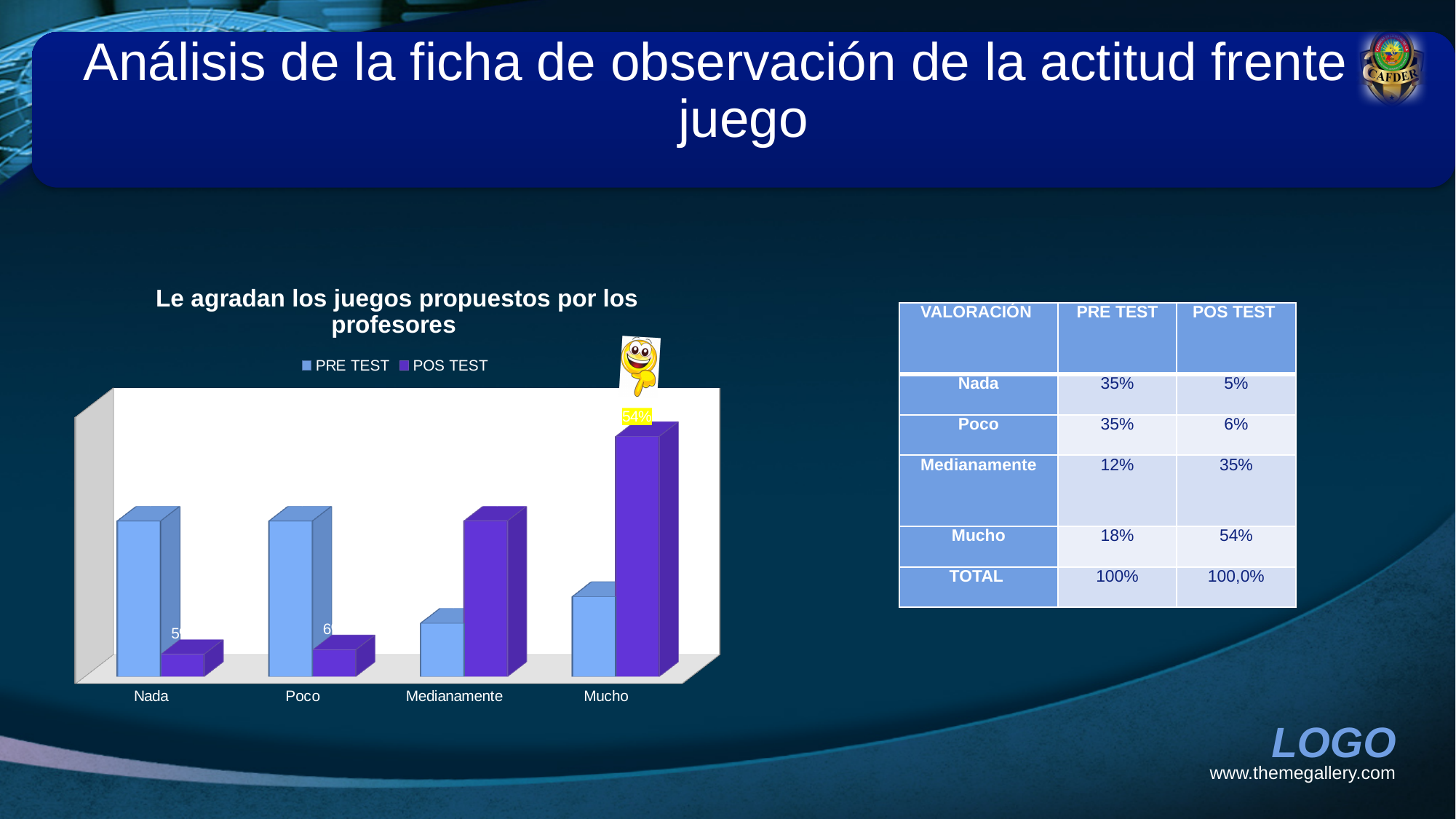
What is the POS TEST value for Mucho? 54% What is the difference between the POS TEST and PRE TEST values for Mucho? 36% How many series does the chart legend list? 2 What is the title of the chart? Le agradan los juegos propuestos por los profesores Do the POS TEST values rise or fall from Nada to Mucho along the x axis? Rise For Mucho, which is larger, the PRE TEST or the POS TEST value? POS TEST Which category has the lowest PRE TEST bar? Medianamente For Nada, which is larger, the PRE TEST or the POS TEST value? PRE TEST Which category has the highest POS TEST bar? Mucho How many categories are shown on the x axis of the chart? 4 What kind of chart is shown on the slide? Bar chart What is the PRE TEST value for Medianamente? 12%